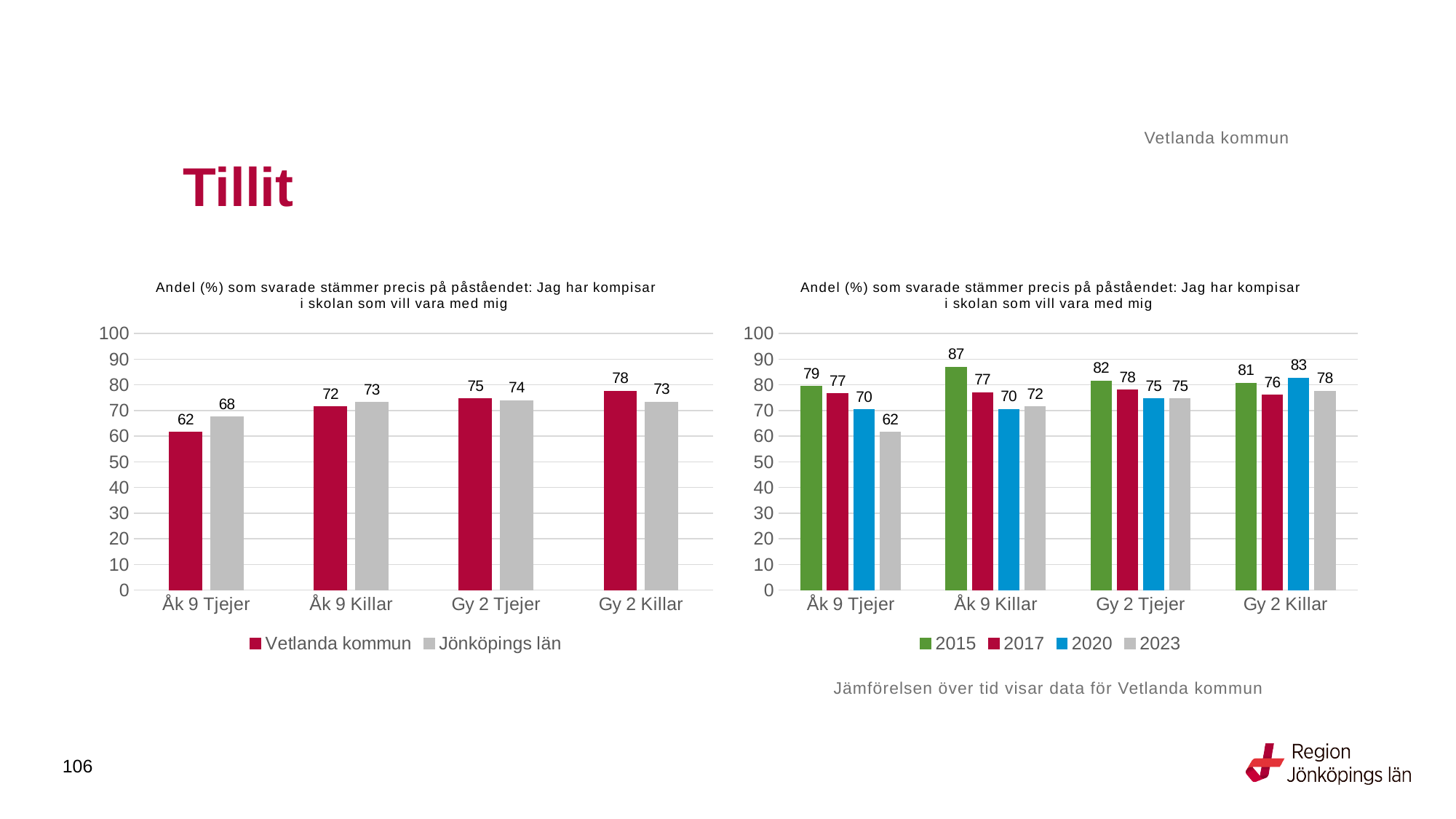
In the right chart, what is the value for 2020 for Gy 2 Killar? 83 What type of chart is the right chart? Bar chart In the left chart, what is the value for Jönköpings län for Gy 2 Killar? 73 In the left chart, which category has the highest value for Vetlanda kommun? Gy 2 Killar In the right chart, what is the value for 2015 for Åk 9 Killar? 87 In the right chart, which category has the lowest value for 2023? Åk 9 Tjejer How many series does the legend of the right chart list? 4 How many series does the legend of the left chart list? 2 In the right chart, what is the difference between the 2015 and 2023 values for Åk 9 Killar? 15 In the left chart, which is larger for Åk 9 Killar: Vetlanda kommun or Jönköpings län? Jönköpings län In the left chart, what is the difference between Vetlanda kommun and Jönköpings län for Åk 9 Tjejer? 6 In the left chart, what is the value for Vetlanda kommun for Åk 9 Tjejer? 62